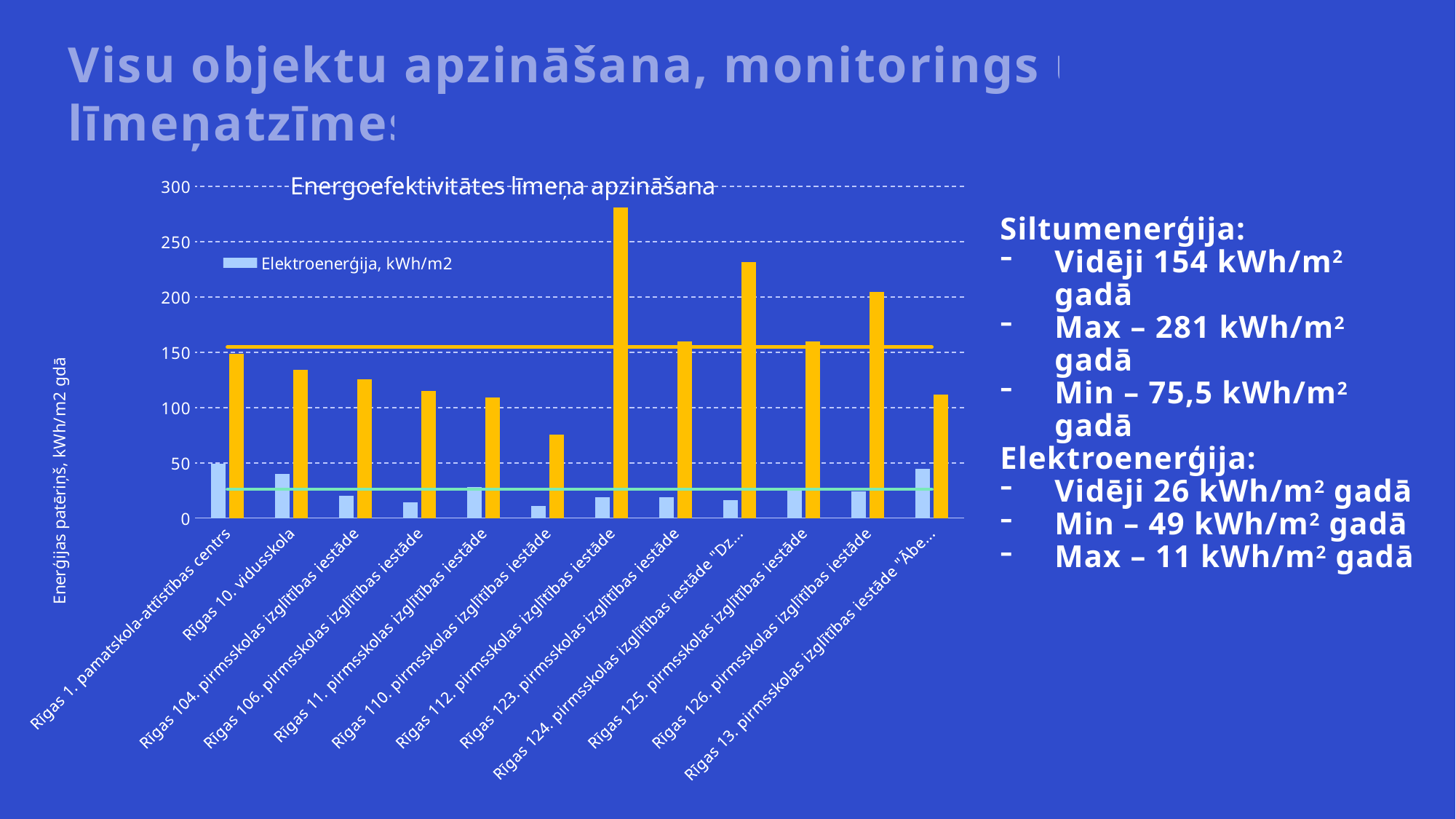
Which has the larger orange bar: Rīgas 124. pirmsskolas izglītības iestāde or Rīgas 126. pirmsskolas izglītības iestāde? Rīgas 124. pirmsskolas izglītības iestāde Is the orange bar for Rīgas 112. pirmsskolas izglītības iestāde greater or less than 250? greater Is the orange bar for Rīgas 124. pirmsskolas izglītības iestāde greater or less than 200? greater Which institution has the lowest orange bar in the chart? Rīgas 110. pirmsskolas izglītības iestāde Which series is named in the chart's legend? Elektroenerģija, kWh/m2 Is the orange bar for Rīgas 10. vidusskola greater or less than 150? less Which institution has the highest orange bar in the chart? Rīgas 112. pirmsskolas izglītības iestāde What kind of chart is shown on the slide? bar chart What is the title of the chart? Energoefektivitātes līmeņa apzināšana Which has the larger light blue (Elektroenerģija) bar: Rīgas 1. pamatskola-attīstības centrs or Rīgas 110. pirmsskolas izglītības iestāde? Rīgas 1. pamatskola-attīstības centrs How many institutions (categories) are shown on the x axis of the chart? 12